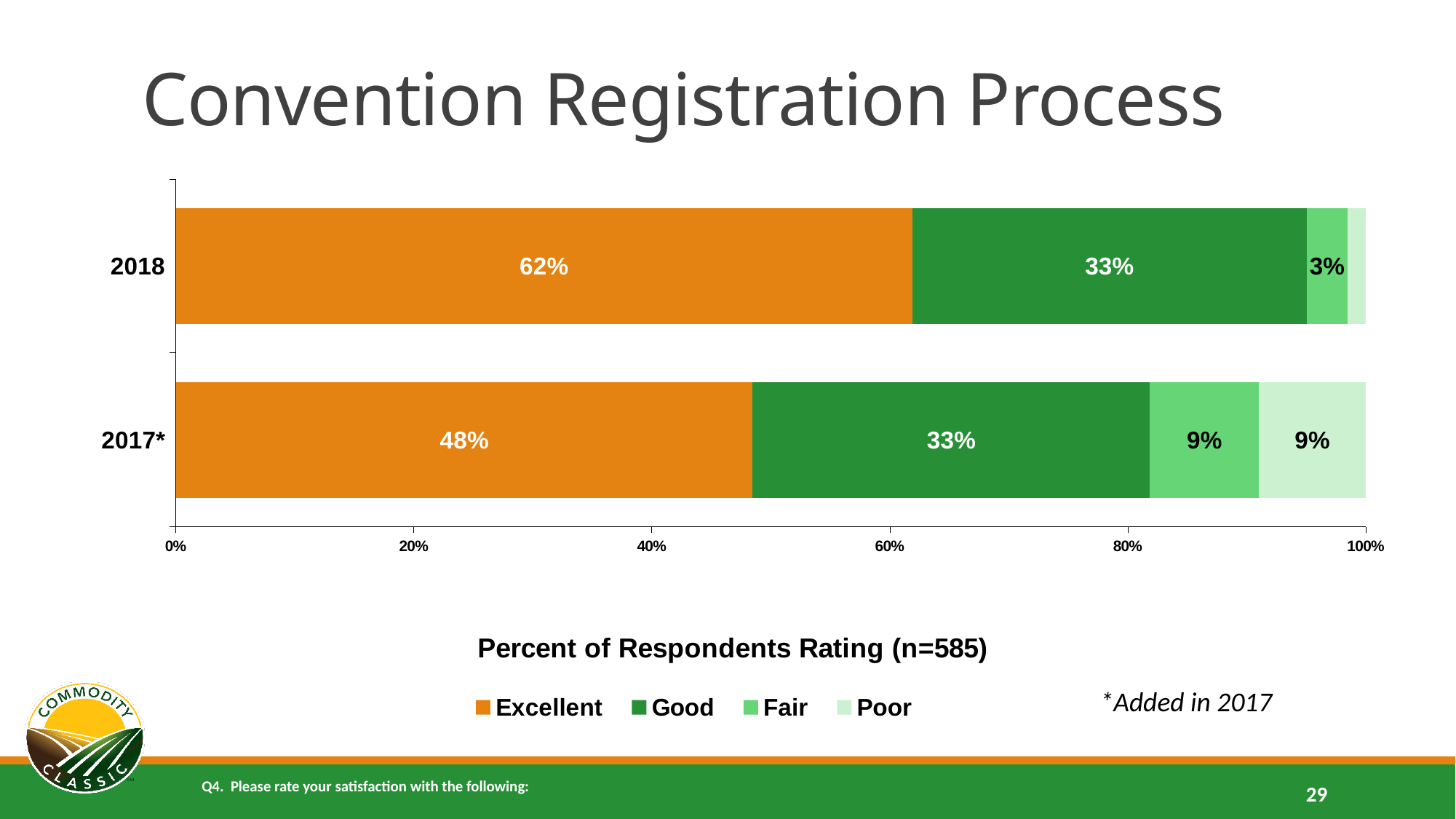
By how many percentage points did the Excellent rating increase from 2017* to 2018? 14 What percentage of respondents rated the convention registration process as Excellent in 2018? 62% How many series does the legend list? 4 What percentage of respondents rated the convention registration process as Excellent in 2017*? 48% What is the Good rating percentage for 2017*? 33% Is the Excellent value for 2018 greater or less than 60%? greater Which year has the higher Excellent rating, 2018 or 2017*? 2018 What type of chart is shown on the slide? Stacked bar chart How many years (categories) are shown in the chart? 2 What is the Poor rating percentage for 2017*? 9% What is the difference between the Fair rating in 2017* and the Fair rating in 2018? 6 What is the Fair rating percentage for 2018? 3%